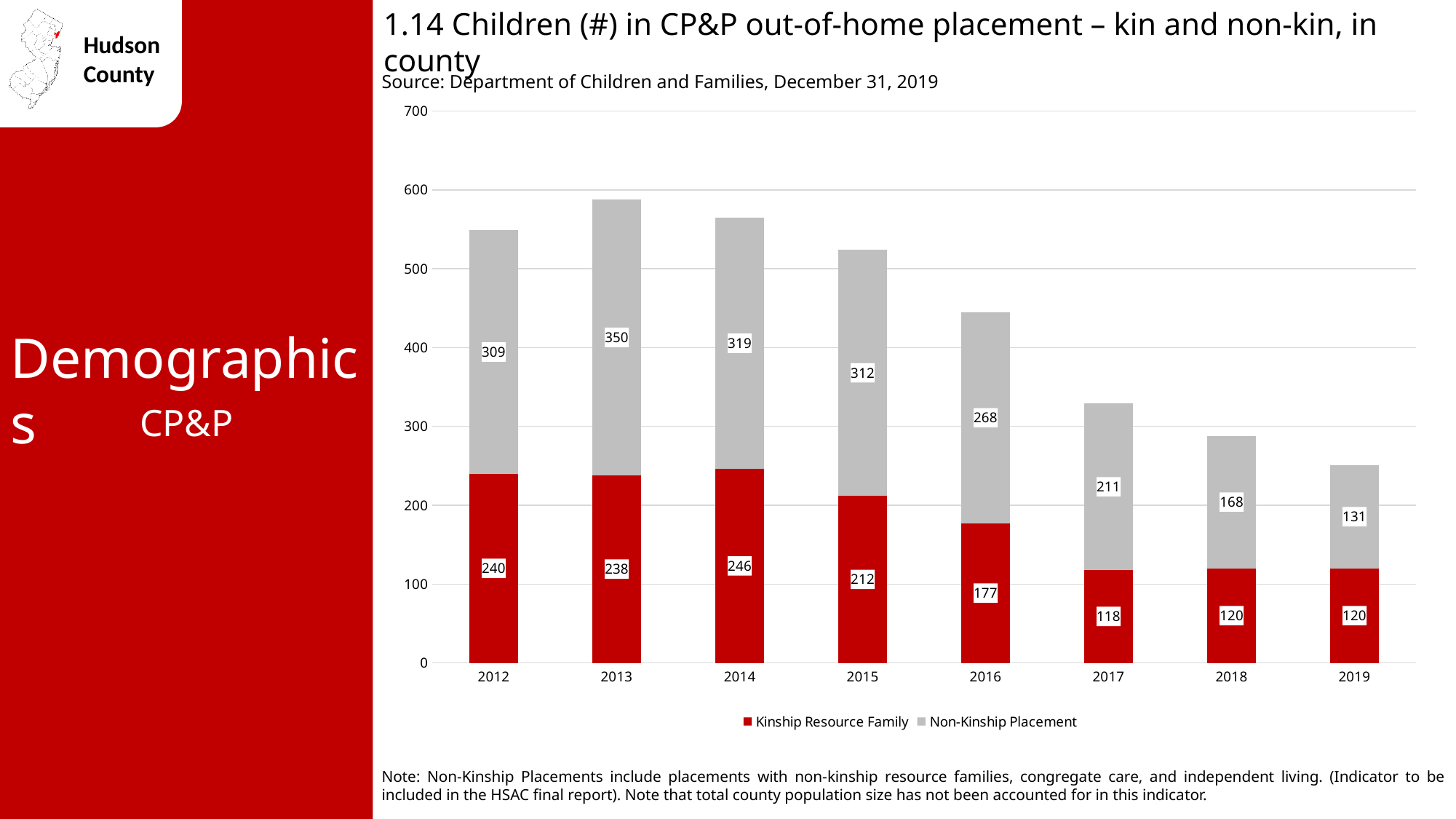
What kind of chart is shown on the slide? Stacked bar chart Is the total stacked bar for 2017 greater or less than 300? greater Do the Non-Kinship Placement values rise or fall from 2013 to 2019? fall What is the Non-Kinship Placement value for 2018? 168 What is the difference between the Non-Kinship Placement values for 2013 and 2019? 219 What is the Kinship Resource Family value for 2015? 212 Which is larger in 2016: the Kinship Resource Family value or the Non-Kinship Placement value? Non-Kinship Placement In which year is the Kinship Resource Family value lowest? 2017 How many series does the legend list? 2 What is the total of the stacked bar for 2012? 549 In which year is the Non-Kinship Placement value highest? 2013 How many years are shown on the x axis? 8